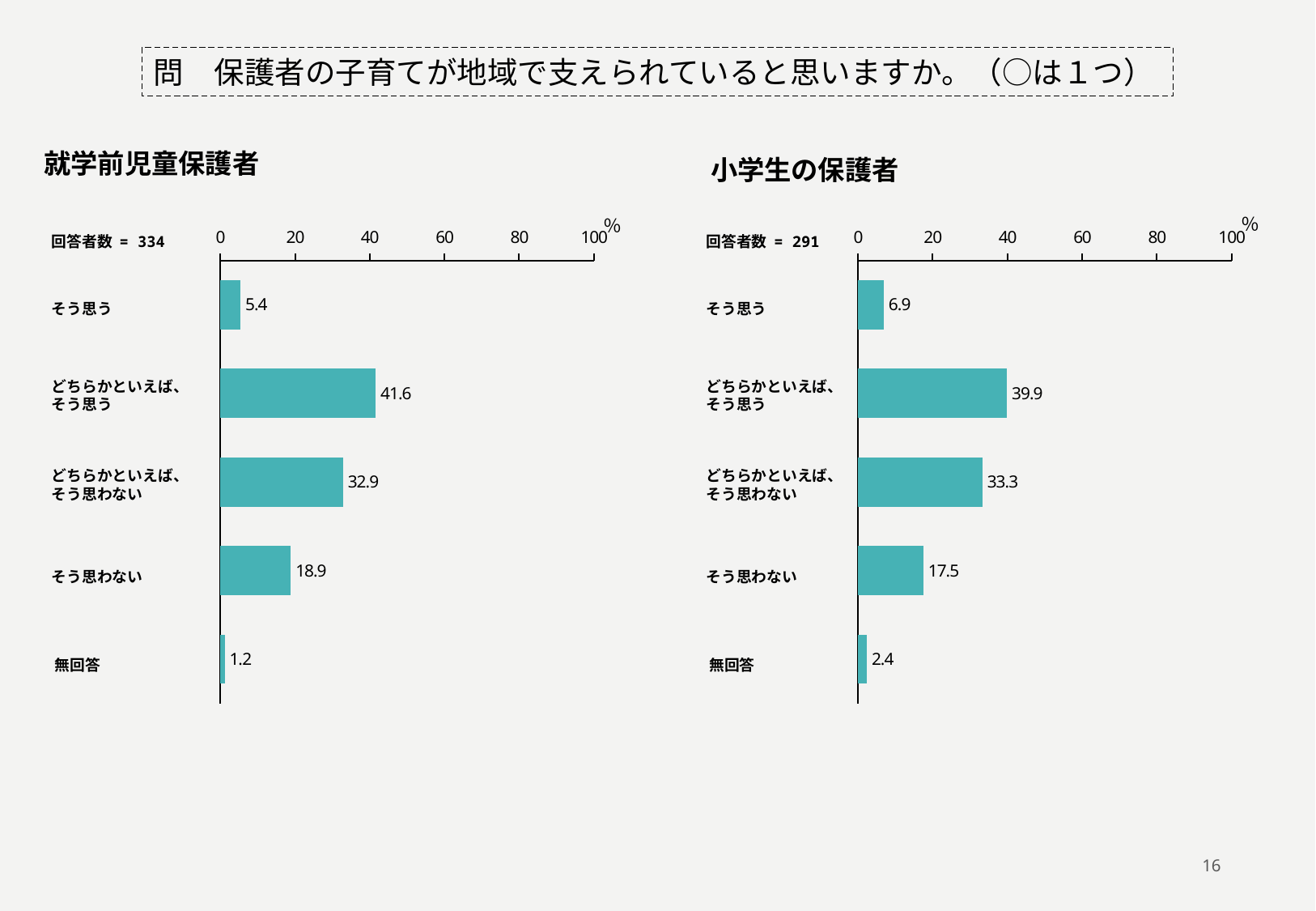
In the 就学前児童保護者 chart, what is the value for そう思う? 5.4 In the 小学生の保護者 chart, is the value for どちらかといえば、そう思わない greater or less than 40? less In the 小学生の保護者 chart, which category has the lowest value? 無回答 What is the number of respondents (回答者数) shown for the 就学前児童保護者 chart? 334 In the 就学前児童保護者 chart, which category has the highest value? どちらかといえば、そう思う In the 小学生の保護者 chart, what is the value for どちらかといえば、そう思う? 39.9 Which is larger: そう思わない in the 就学前児童保護者 chart or そう思わない in the 小学生の保護者 chart? 就学前児童保護者 (18.9) In the 就学前児童保護者 chart, what is the difference between どちらかといえば、そう思う and どちらかといえば、そう思わない? 8.7 What kind of chart is the 小学生の保護者 chart? bar chart What is the number of respondents (回答者数) shown for the 小学生の保護者 chart? 291 How many categories are shown in the 就学前児童保護者 chart? 5 In the 小学生の保護者 chart, what is the value for 無回答? 2.4